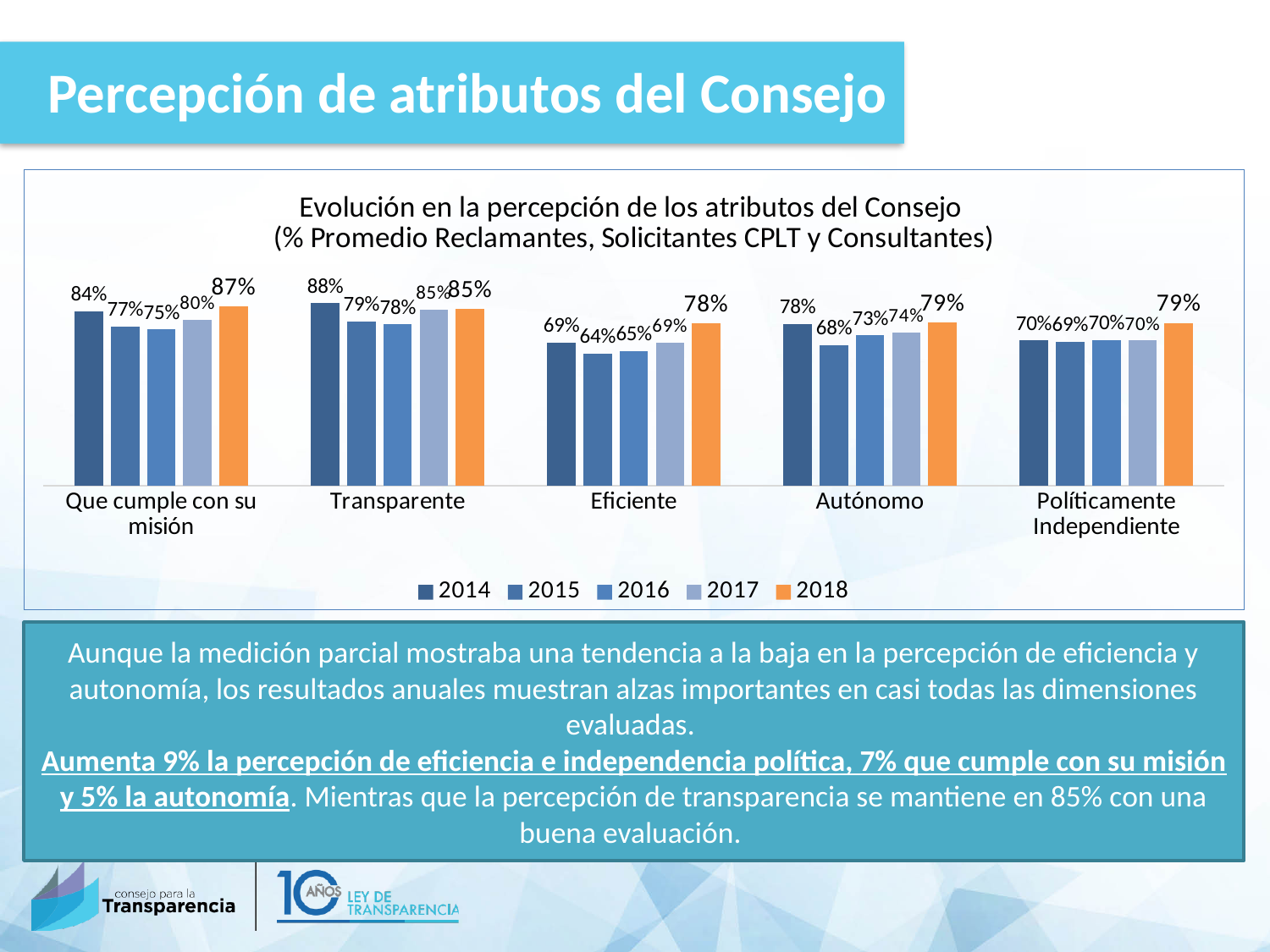
Which category has the lowest value in 2015? Eficiente What is the value for Políticamente Independiente in 2017? 70% What kind of chart is shown? Bar chart Which year is shown in orange in the legend? 2018 How many series does the legend list? 5 Which is larger, the 2014 value for Que cumple con su misión or the 2014 value for Autónomo? Que cumple con su misión How many categories are shown on the x axis? 5 What is the value for Eficiente in 2018? 78% What is the value for Autónomo in 2015? 68% What is the value for Transparente in 2014? 88% What is the difference between the 2018 and 2017 values for Eficiente? 9% Which category has the highest value in 2018? Que cumple con su misión